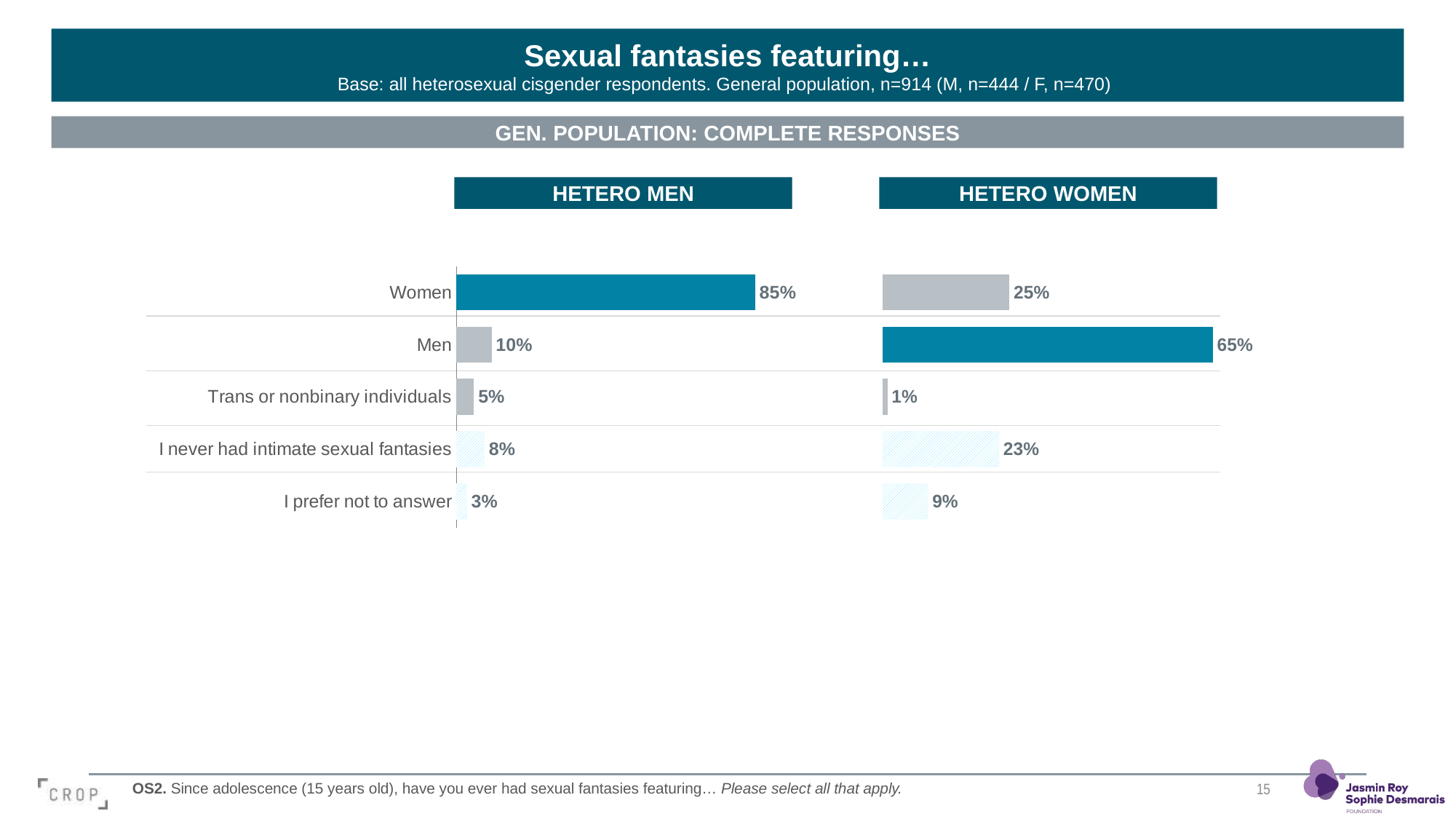
What kind of chart is the HETERO WOMEN chart? Bar chart In the HETERO WOMEN chart, what is the value for Men? 65% Which is larger: the value for I never had intimate sexual fantasies in the HETERO MEN chart or in the HETERO WOMEN chart? HETERO WOMEN In the HETERO MEN chart, which category has the highest value? Women In the HETERO MEN chart, what is the difference between the values for Women and Men? 75% In the HETERO WOMEN chart, what is the value for Trans or nonbinary individuals? 1% In the HETERO MEN chart, what is the value for Women? 85% In the HETERO WOMEN chart, what is the difference between the values for Men and Women? 40% In the HETERO MEN chart, what is the value for I never had intimate sexual fantasies? 8% In the HETERO WOMEN chart, which category has the lowest value? Trans or nonbinary individuals How many categories are shown in the HETERO MEN chart? 5 In the HETERO MEN chart, which category has the lowest value? I prefer not to answer